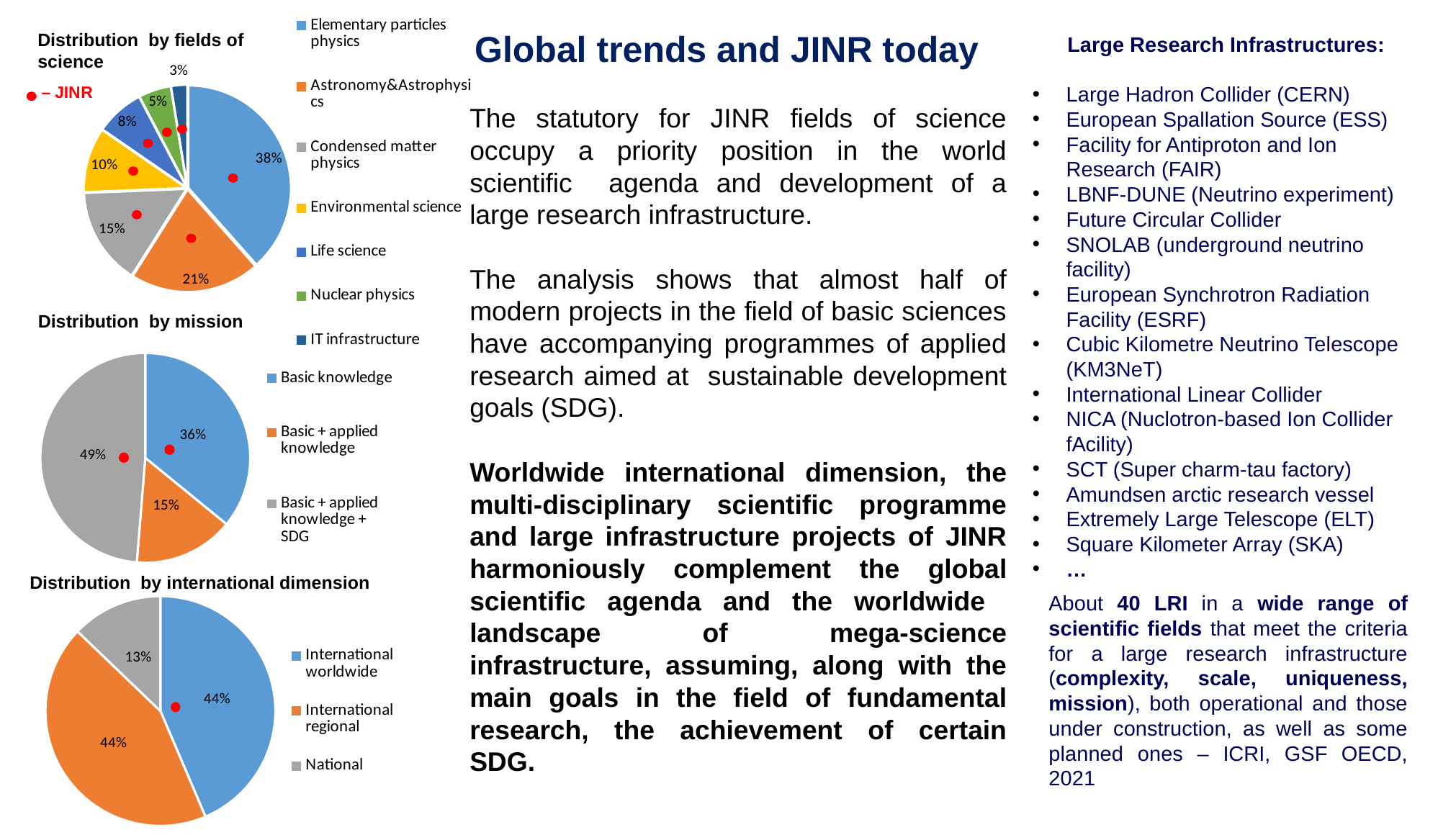
In the 'Distribution by fields of science' chart, what share does Elementary particles physics have? 38% In the 'Distribution by mission' chart, which category has the smallest share? Basic + applied knowledge In the 'Distribution by fields of science' chart, what is the difference between the shares of Astronomy&Astrophysics and Condensed matter physics? 6% In the 'Distribution by fields of science' chart, what share does Environmental science have? 10% In the 'Distribution by international dimension' chart, what share does National have? 13% In the 'Distribution by mission' chart, which is larger: Basic knowledge or Basic + applied knowledge + SDG? Basic + applied knowledge + SDG In the 'Distribution by fields of science' chart, which field has the smallest share? IT infrastructure What type of chart is 'Distribution by international dimension'? Pie chart How many categories does the 'Distribution by fields of science' pie chart have? 7 In the 'Distribution by mission' chart, what share does Basic + applied knowledge + SDG have? 49% In the 'Distribution by fields of science' chart, which field has the largest share? Elementary particles physics How many entries does the legend of the 'Distribution by mission' chart list? 3